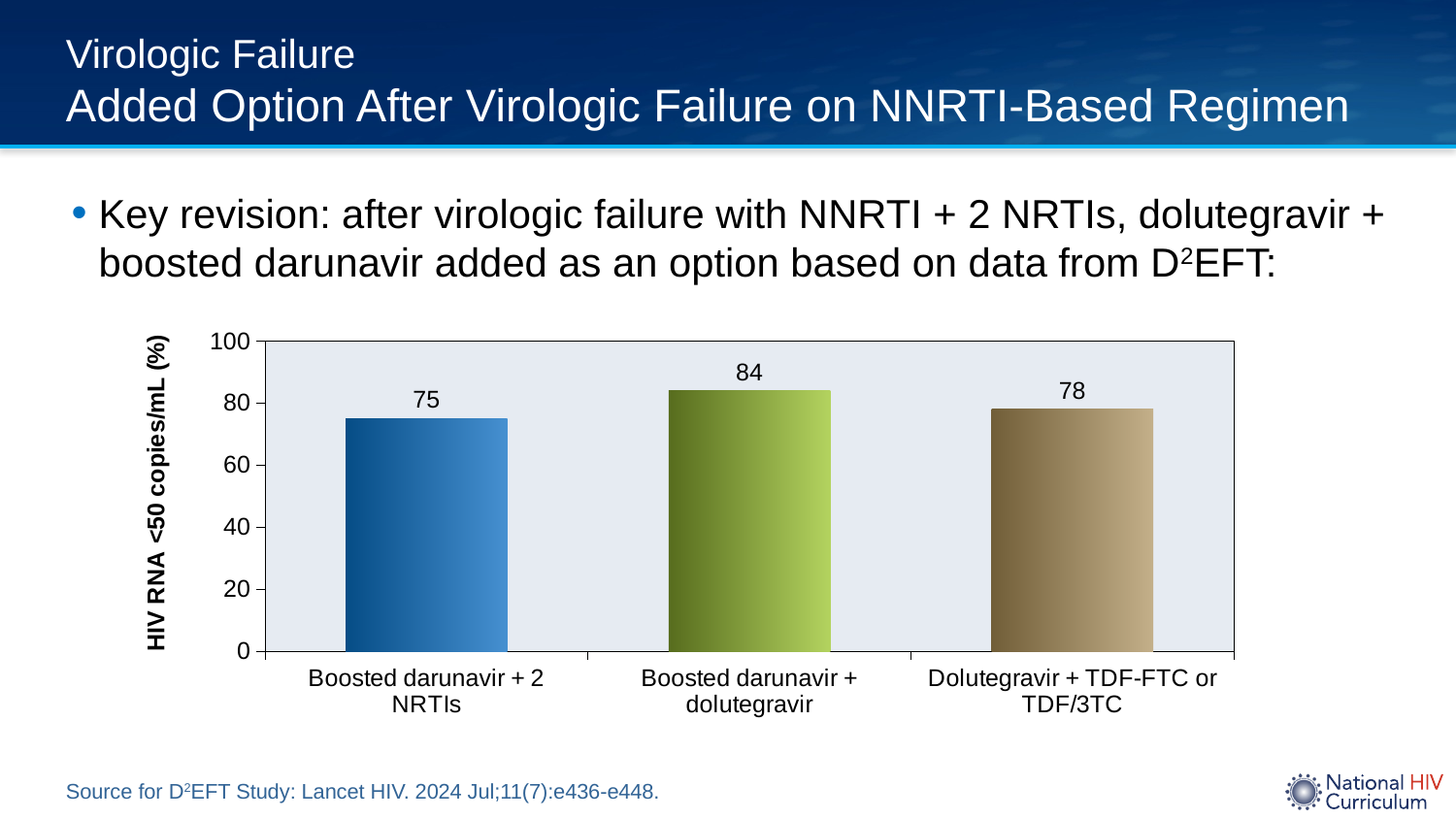
Which regimen has the highest percentage of HIV RNA <50 copies/mL? Boosted darunavir + dolutegravir What kind of chart is shown on the slide? bar chart What is the difference between the values for Boosted darunavir + dolutegravir and Boosted darunavir + 2 NRTIs? 9 How many regimens are shown in the chart? 3 What is the difference between the values for Boosted darunavir + dolutegravir and Dolutegravir + TDF-FTC or TDF/3TC? 6 What is the value for Boosted darunavir + dolutegravir? 84 What is the label of the y axis? HIV RNA <50 copies/mL (%) What is the value for Dolutegravir + TDF-FTC or TDF/3TC? 78 Which regimen has the lowest percentage of HIV RNA <50 copies/mL? Boosted darunavir + 2 NRTIs Which is larger, the value for Dolutegravir + TDF-FTC or TDF/3TC or the value for Boosted darunavir + 2 NRTIs? Dolutegravir + TDF-FTC or TDF/3TC Is the value for Boosted darunavir + 2 NRTIs greater or less than 80? less What is the value for Boosted darunavir + 2 NRTIs? 75